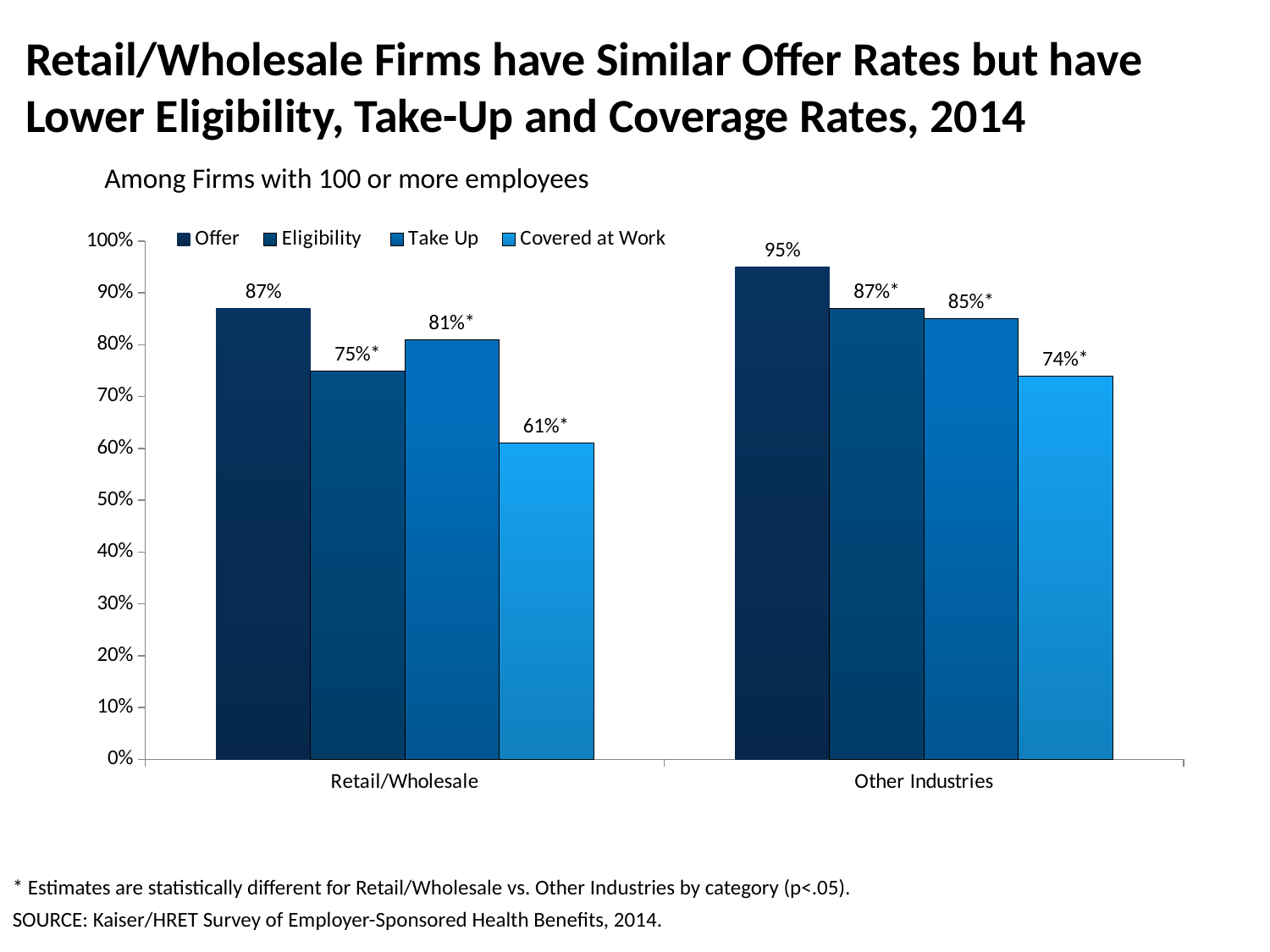
What is the Offer rate for Retail/Wholesale firms? 87% What is the Take Up rate for Other Industries? 85% How many categories are shown on the x axis? 2 What is the Eligibility rate for Retail/Wholesale firms? 75% Which is larger, the Eligibility rate for Retail/Wholesale or the Eligibility rate for Other Industries? Other Industries How many series does the legend list? 4 What is the difference between the Covered at Work rates for Other Industries and Retail/Wholesale? 13% What kind of chart is shown on the slide? Bar chart What is the difference between the Offer rates for Other Industries and Retail/Wholesale? 8% Which series has the highest value for Other Industries? Offer Which series has the lowest value for Retail/Wholesale? Covered at Work What is the Covered at Work rate for Other Industries? 74%